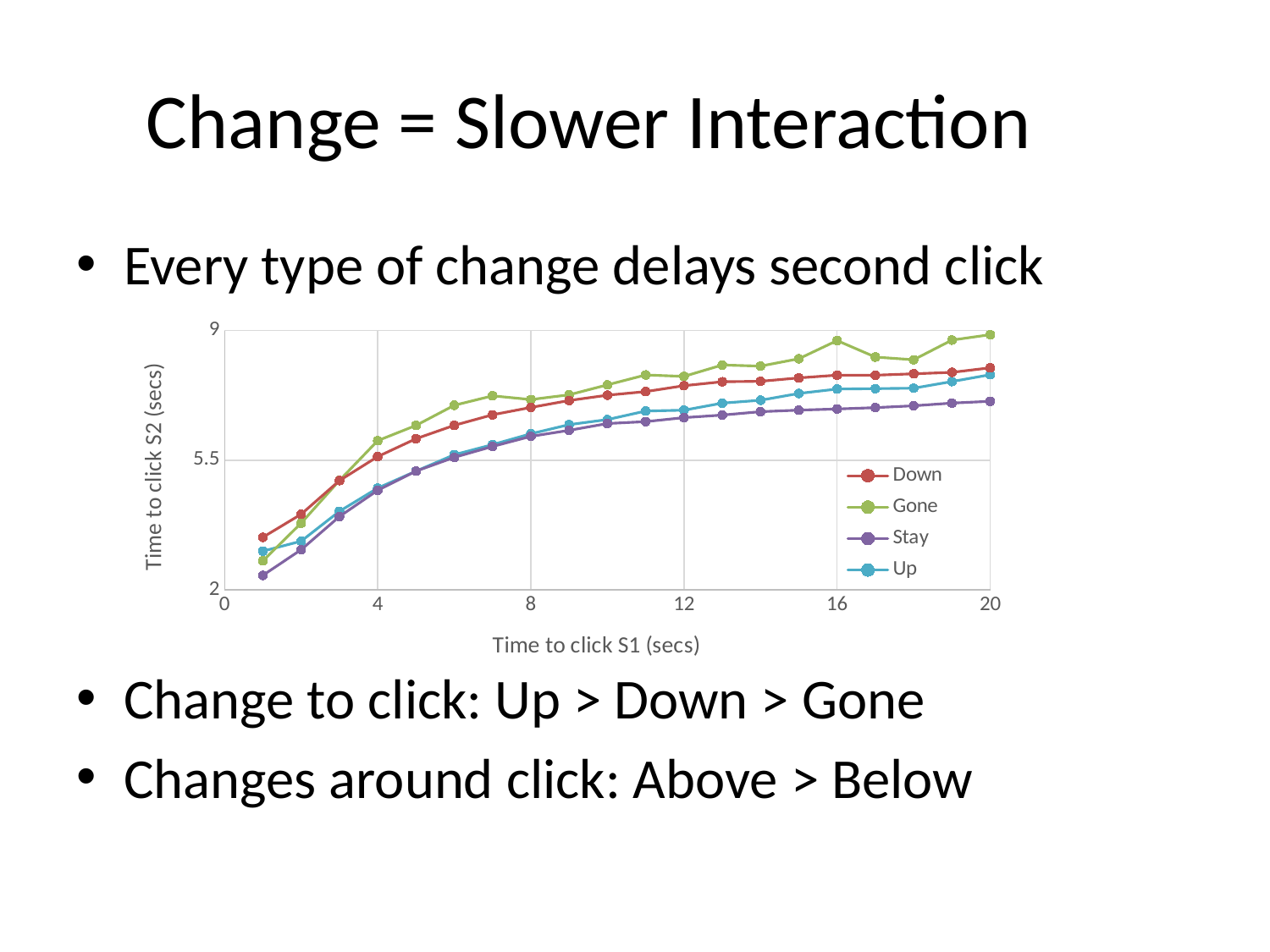
What is the title of the x axis? Time to click S1 (secs) Is the value of the Stay series at Time to click S1 = 1 sec greater or less than 5.5? less At Time to click S1 = 1 sec, which series has the larger value, Down or Stay? Down Is the value of the Down series at Time to click S1 = 8 secs greater or less than 5.5? greater How many series does the legend list? 4 Do the values of the Down series rise or fall as Time to click S1 increases? rise Which series has the highest value at Time to click S1 = 20 secs? Gone What kind of chart is shown on the slide? line chart What are the series names listed in the legend? Down, Gone, Stay, Up How many data points does each series have? 20 Which series has the lowest value at Time to click S1 = 20 secs? Stay At Time to click S1 = 16 secs, which series has the larger value, Gone or Up? Gone